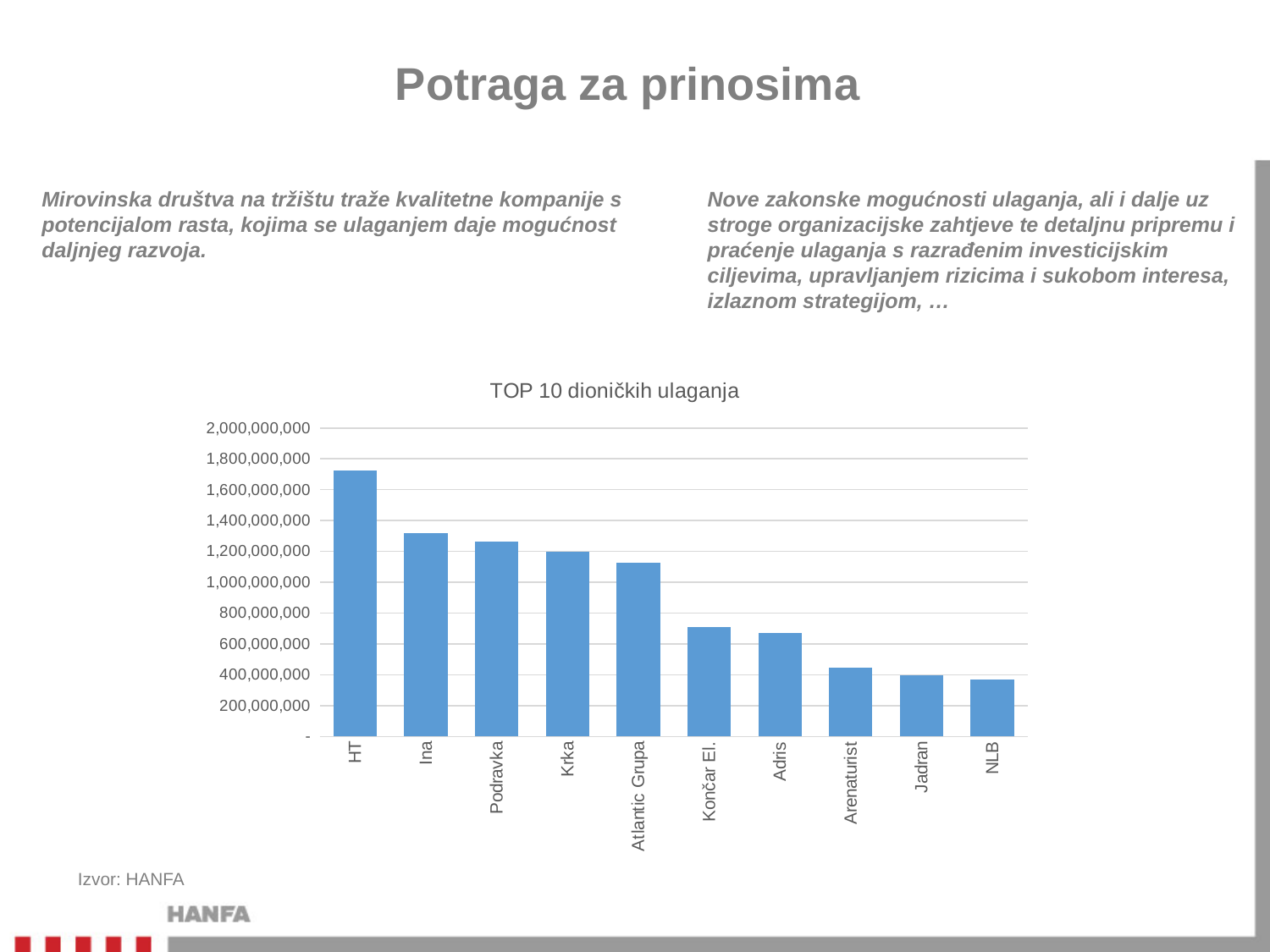
Is the value for Ina greater or less than 1,200,000,000? greater Which has the larger value, Krka or Adris? Krka Is the value for NLB greater or less than 400,000,000? less Is the value for HT greater or less than 1,600,000,000? greater Do the values rise or fall from left to right along the x axis? Fall Which has the larger value, HT or Ina? HT Which company has the highest value in the chart? HT What kind of chart is shown on the slide? Bar chart How many companies are shown in the chart? 10 What is the title of the chart? TOP 10 dioničkih ulaganja